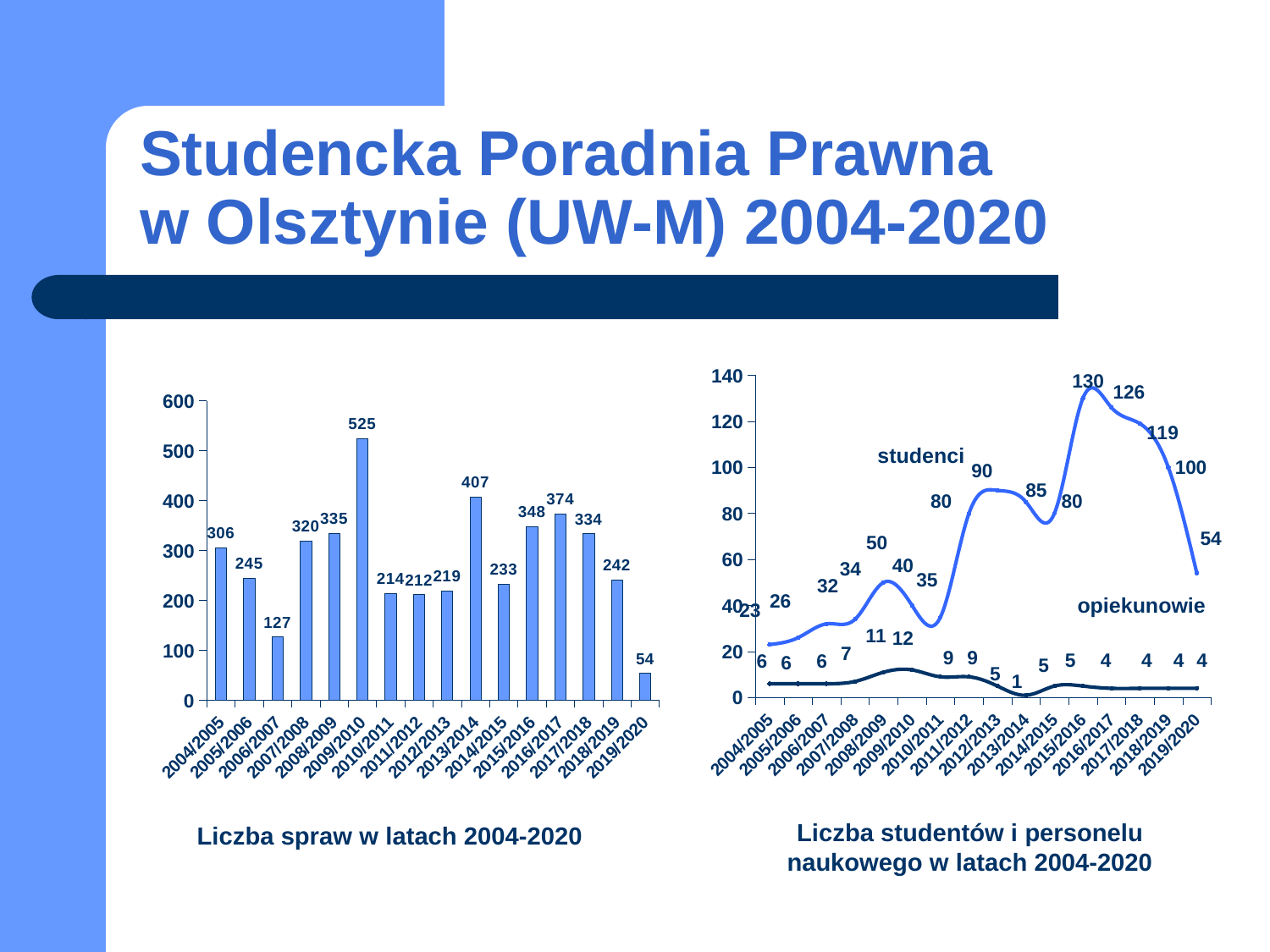
In the bar chart 'Liczba spraw w latach 2004-2020', which year has the lowest number of cases? 2019/2020 In the line chart 'Liczba studentów i personelu naukowego w latach 2004-2020', what is the value of the 'opiekunowie' series for 2009/2010? 12 In the bar chart 'Liczba spraw w latach 2004-2020', which is larger, the value for 2016/2017 or the value for 2017/2018? 2016/2017 In the bar chart 'Liczba spraw w latach 2004-2020', which year has the highest number of cases? 2009/2010 What kind of chart is the left chart, 'Liczba spraw w latach 2004-2020'? bar chart In the bar chart 'Liczba spraw w latach 2004-2020', what is the value for 2009/2010? 525 In the bar chart 'Liczba spraw w latach 2004-2020', what is the difference between the values for 2013/2014 and 2014/2015? 174 In the line chart 'Liczba studentów i personelu naukowego w latach 2004-2020', what is the value of the 'studenci' series for 2019/2020? 54 In the line chart 'Liczba studentów i personelu naukowego w latach 2004-2020', what is the highest value of the 'studenci' series? 130 In the line chart 'Liczba studentów i personelu naukowego w latach 2004-2020', what is the value of the 'opiekunowie' series for 2013/2014? 1 How many years are shown on the x axis of the bar chart 'Liczba spraw w latach 2004-2020'? 16 How many series are plotted in the line chart 'Liczba studentów i personelu naukowego w latach 2004-2020'? 2